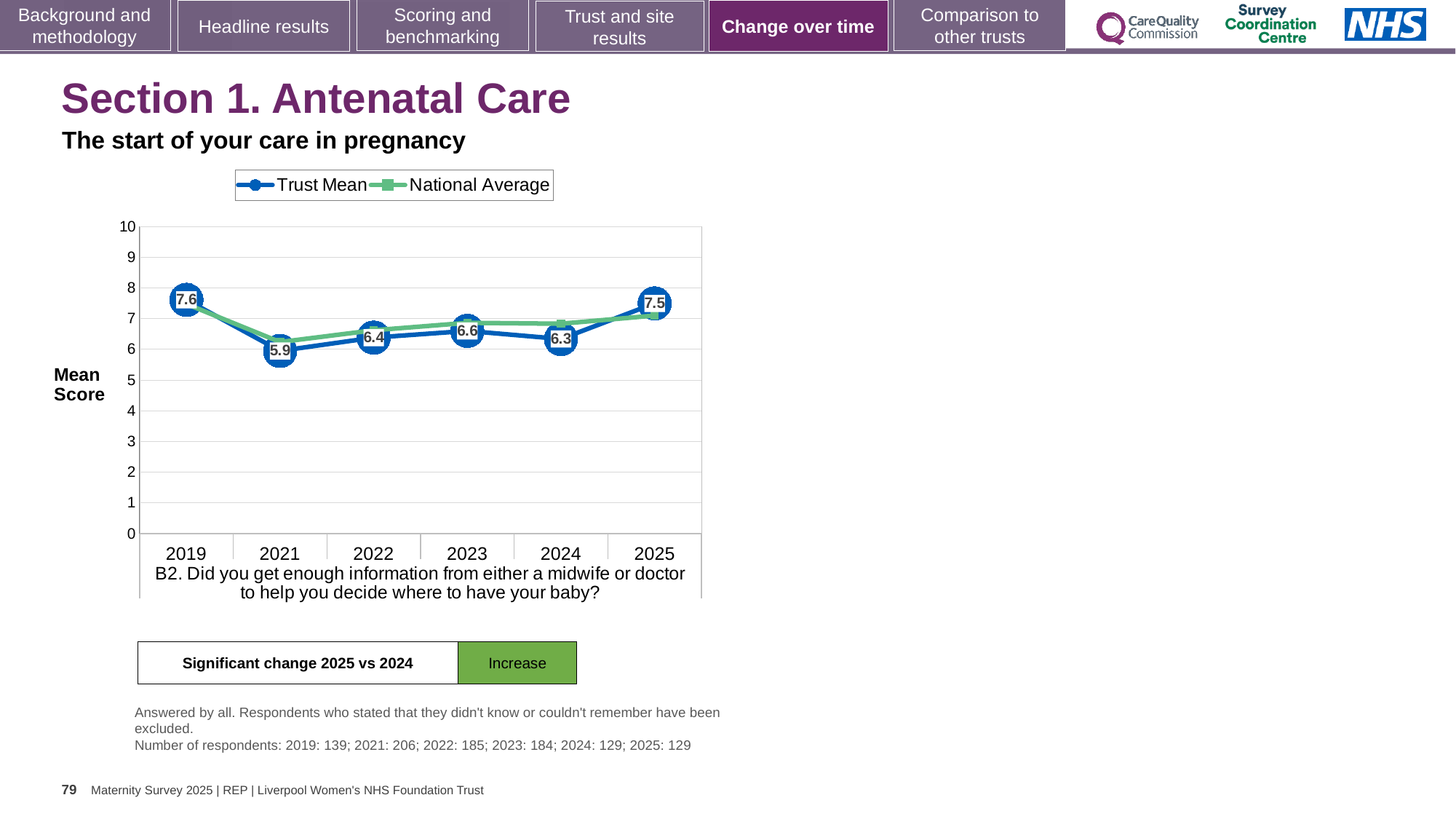
How many years are plotted on the x axis? 6 What is the Trust Mean score for 2025? 7.5 Does the Trust Mean rise or fall from 2024 to 2025? rise Is the National Average for 2021 greater or less than 7? less Which year has the highest Trust Mean score? 2019 How many series does the legend list? 2 Which is larger, the Trust Mean score for 2023 or for 2024? 2023 What is the difference between the Trust Mean scores for 2019 and 2021? 1.7 Which year has the lowest Trust Mean score? 2021 What is the Trust Mean score for 2019? 7.6 What is the Trust Mean score for 2021? 5.9 What kind of chart is shown on the slide? line chart